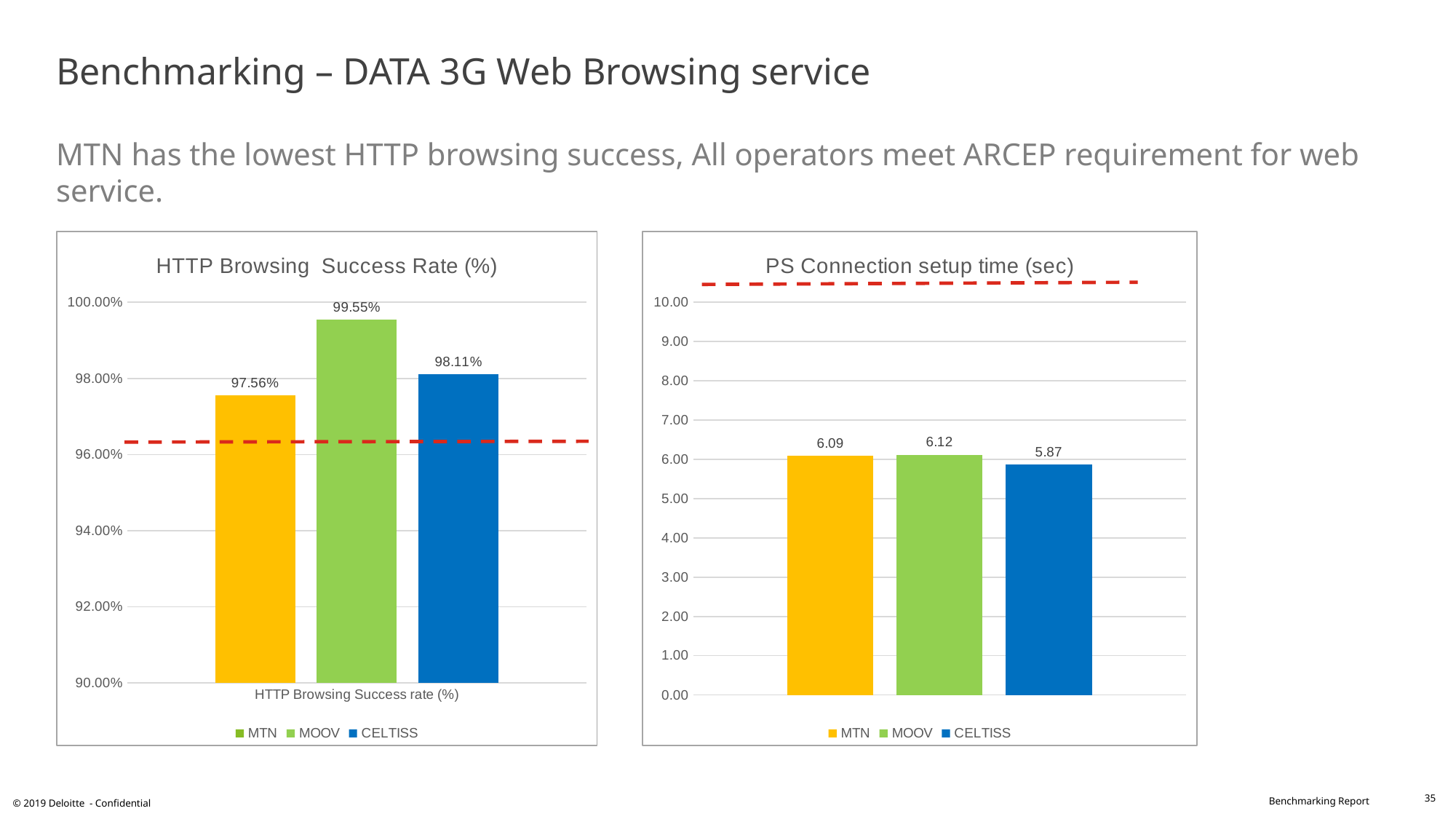
In the HTTP Browsing Success Rate (%) chart, which operator has the highest success rate? MOOV In the HTTP Browsing Success Rate (%) chart, which operator has the lowest success rate? MTN What kind of chart is the PS Connection setup time (sec) chart? Bar chart In the HTTP Browsing Success Rate (%) chart, what is the value for MOOV? 99.55% In the PS Connection setup time (sec) chart, what is the difference between the MOOV and CELTISS values? 0.25 In the PS Connection setup time (sec) chart, is the value for MOOV greater or less than 7.00? less In the PS Connection setup time (sec) chart, which operator has the lowest setup time? CELTISS In the PS Connection setup time (sec) chart, what is the value for CELTISS? 5.87 In the PS Connection setup time (sec) chart, what is the value for MTN? 6.09 In the HTTP Browsing Success Rate (%) chart, what is the difference between the MOOV and MTN values? 1.99% In the HTTP Browsing Success Rate (%) chart, what is the value for MTN? 97.56% In the HTTP Browsing Success Rate (%) chart, how many series does the legend list? 3